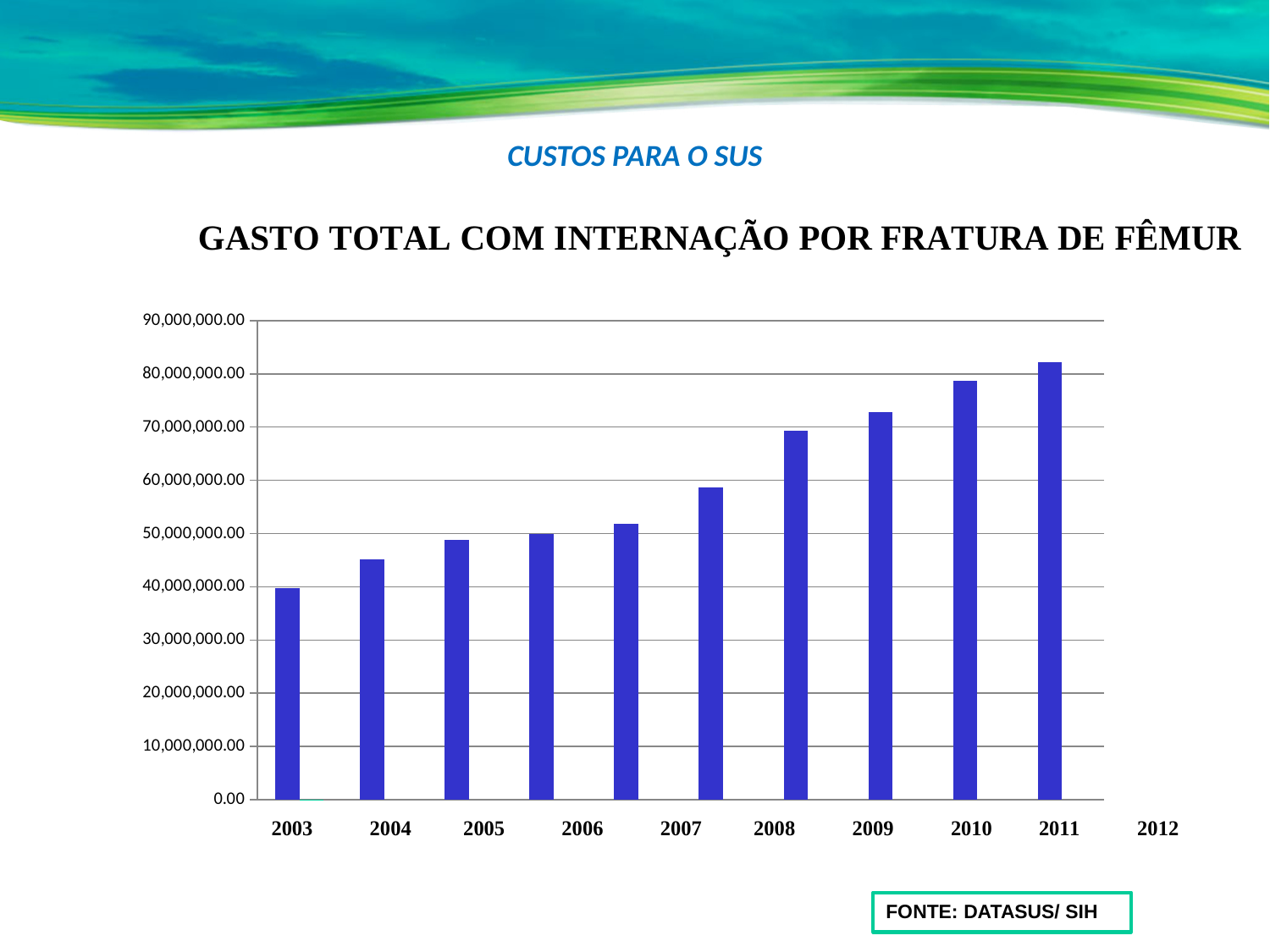
Is the value of the rightmost bar greater or less than 80,000,000.00? greater Is the value of the leftmost bar greater or less than 30,000,000.00? greater What is the highest value shown on the vertical axis? 90,000,000.00 Which bar is the tallest, the leftmost or the rightmost? rightmost Is the value of the second bar from the left greater or less than 40,000,000.00? greater How many bars are plotted in the chart? 10 What source is cited for the chart data? DATASUS/ SIH What kind of chart is shown on the slide? bar chart What is the title of the chart? GASTO TOTAL COM INTERNAÇÃO POR FRATURA DE FÊMUR Do the values generally rise or fall from left to right along the x axis? rise